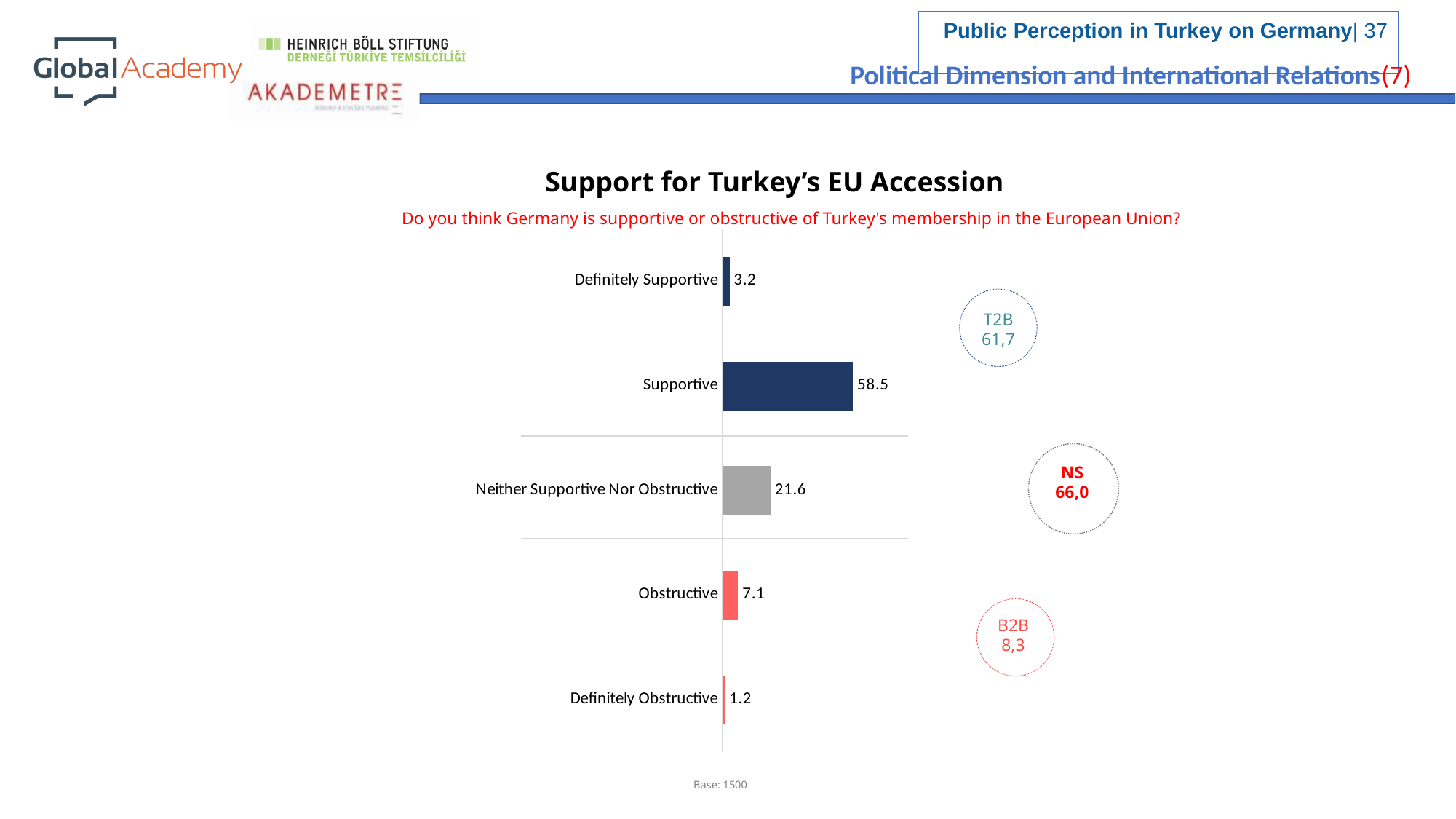
What is the value for Definitely Obstructive? 1.2 What is the title of the chart? Support for Turkey's EU Accession What is the value for Definitely Supportive? 3.2 What is the value for Supportive? 58.5 What is the value for Obstructive? 7.1 Which is larger, the value for Obstructive or the value for Definitely Supportive? Obstructive Which category has the lowest value? Definitely Obstructive What kind of chart is shown on the slide? Bar chart What is the difference between the values for Supportive and Neither Supportive Nor Obstructive? 36.9 Which category has the highest value? Supportive How many categories are shown in the chart? 5 What is the value for Neither Supportive Nor Obstructive? 21.6